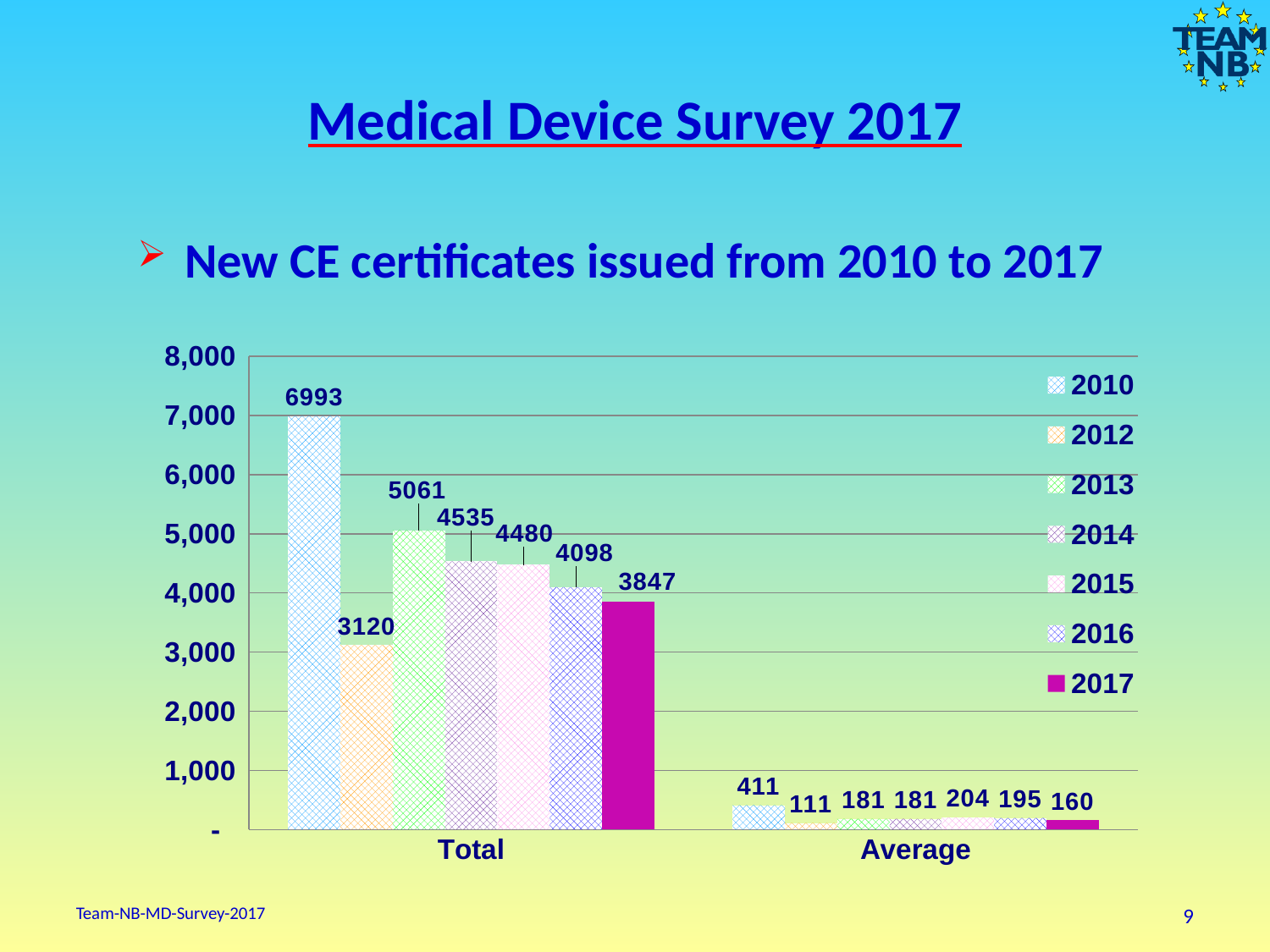
Is the Total value for 2017 greater or less than 4,000? less What is the Total value for 2017? 3847 What is the Average value for 2012? 111 What is the Total value for 2010? 6993 Which is larger, the Total value for 2013 or the Total value for 2016? 2013 What kind of chart is shown on the slide? bar chart How many series does the legend list? 7 Which year has the highest Total value? 2010 What is the difference between the Total values for 2010 and 2012? 3873 Which year has the lowest Total value? 2012 How many categories are shown on the x axis? 2 What is the Average value for 2015? 204